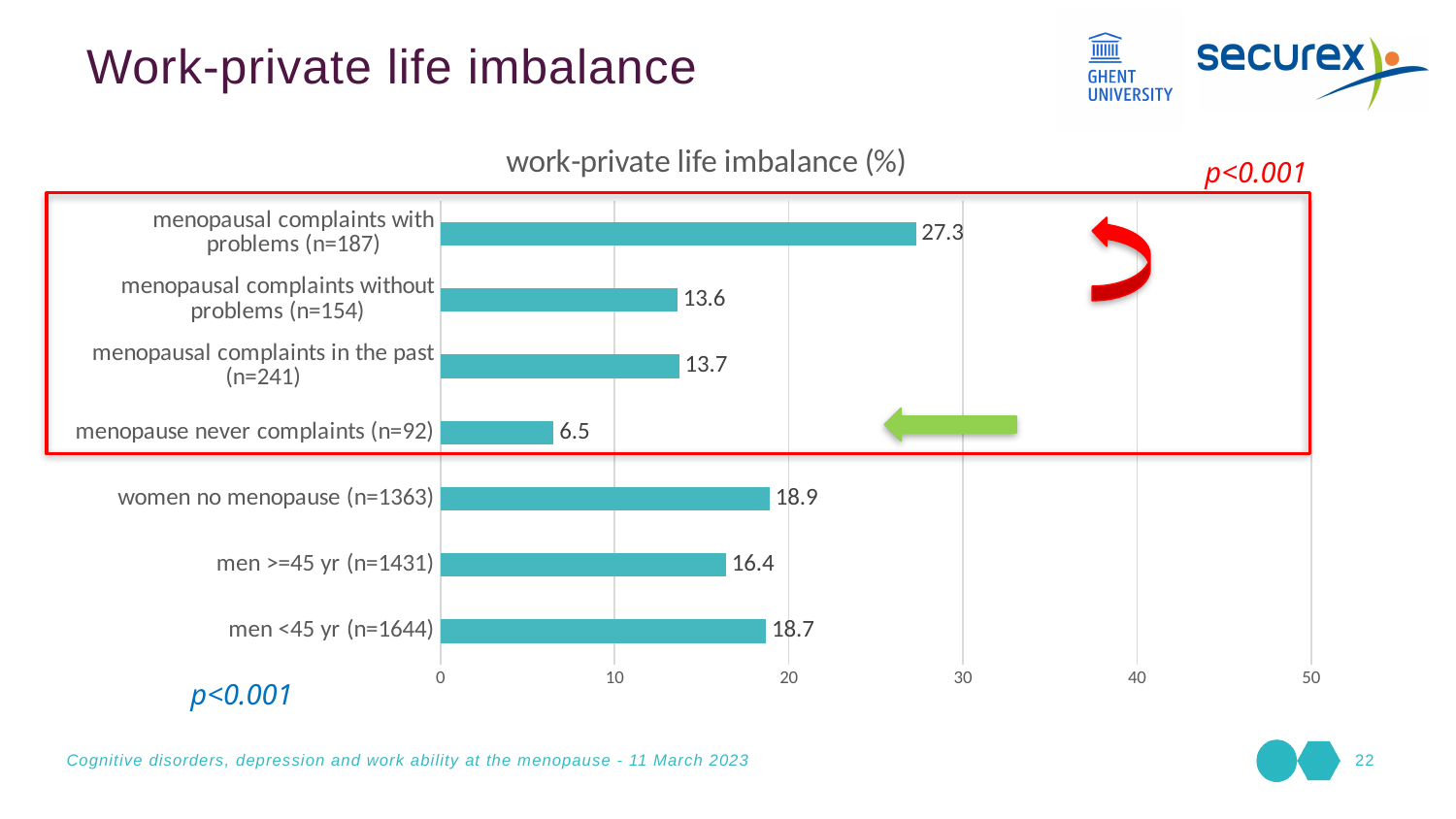
Which category has the highest work-private life imbalance value? menopausal complaints with problems (n=187) What is the difference between the values for women no menopause (n=1363) and men >=45 yr (n=1431)? 2.5 Is the value for menopausal complaints in the past (n=241) greater or less than 20? less What kind of chart is shown on the slide? bar chart Which category has the lowest work-private life imbalance value? menopause never complaints (n=92) Which is larger, the value for men <45 yr (n=1644) or the value for men >=45 yr (n=1431)? men <45 yr (n=1644) How many categories are shown in the chart? 7 What is the value shown for women no menopause (n=1363)? 18.9 What is the value shown for men >=45 yr (n=1431)? 16.4 What is the difference between the values for menopausal complaints with problems (n=187) and menopausal complaints without problems (n=154)? 13.7 What is the work-private life imbalance value for menopausal complaints with problems (n=187)? 27.3 What is the title of the chart? work-private life imbalance (%)